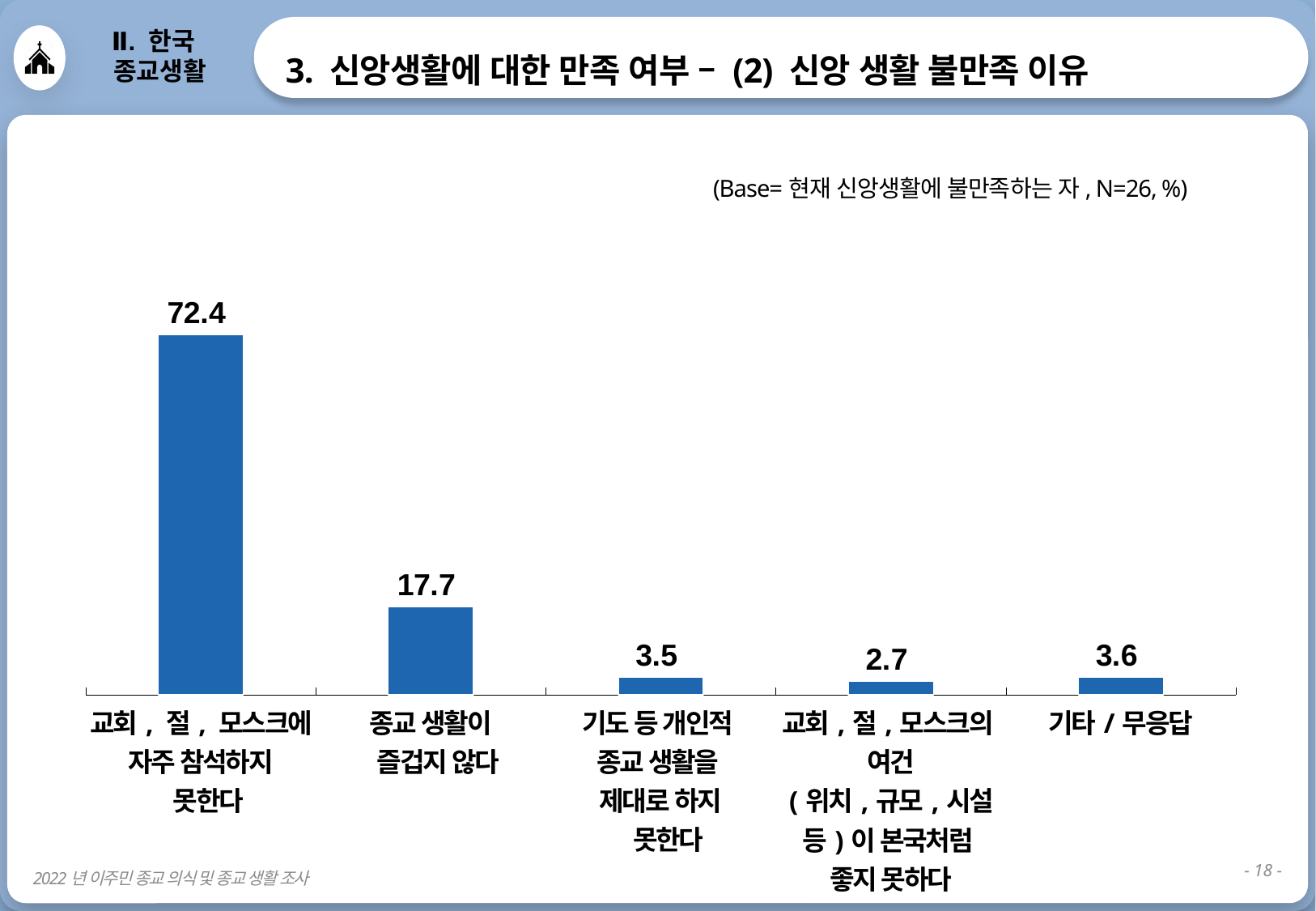
What kind of chart is shown on the slide? Bar chart What is the value for '교회, 절, 모스크에 자주 참석하지 못한다'? 72.4 How many categories are shown in the chart? 5 What is the difference between the values for '교회, 절, 모스크에 자주 참석하지 못한다' and '종교 생활이 즐겁지 않다'? 54.7 What is the value for '기도 등 개인적 종교 생활을 제대로 하지 못한다'? 3.5 What is the base (N) stated for the chart? N=26 What is the value for '종교 생활이 즐겁지 않다'? 17.7 Which category has the highest value? 교회, 절, 모스크에 자주 참석하지 못한다 Which is larger: the value for '종교 생활이 즐겁지 않다' or the value for '기타 / 무응답'? 종교 생활이 즐겁지 않다 What is the value for '교회, 절, 모스크의 여건(위치, 규모, 시설 등)이 본국처럼 좋지 못하다'? 2.7 Which category has the lowest value? 교회, 절, 모스크의 여건(위치, 규모, 시설 등)이 본국처럼 좋지 못하다 What is the value for '기타 / 무응답'? 3.6